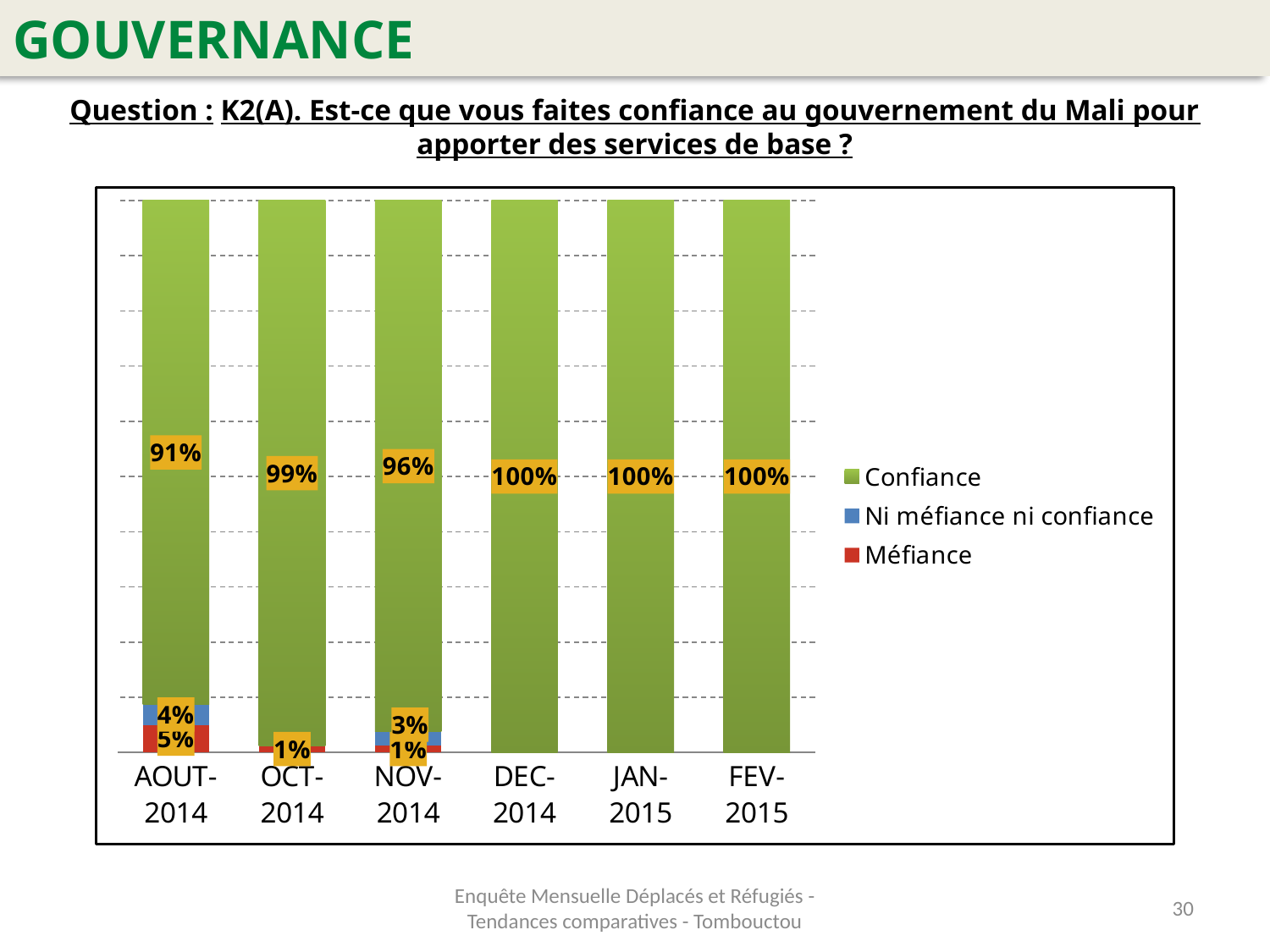
How many series does the legend list? 3 How many months are shown on the x axis? 6 Which month has the higher Confiance value, OCT-2014 or NOV-2014? OCT-2014 Which month has the lowest Confiance value? AOUT-2014 By how many percentage points is the Confiance value for NOV-2014 higher than for AOUT-2014? 5 percentage points What kind of chart is shown on the slide? Stacked bar chart What is the Ni méfiance ni confiance value for NOV-2014? 3% What is the Confiance value for OCT-2014? 99% What is the total of the three segments in the AOUT-2014 bar? 100% What percentage of respondents answered Confiance in AOUT-2014? 91% How many months show a Confiance value of 100%? 3 What is the Méfiance value for AOUT-2014? 5%